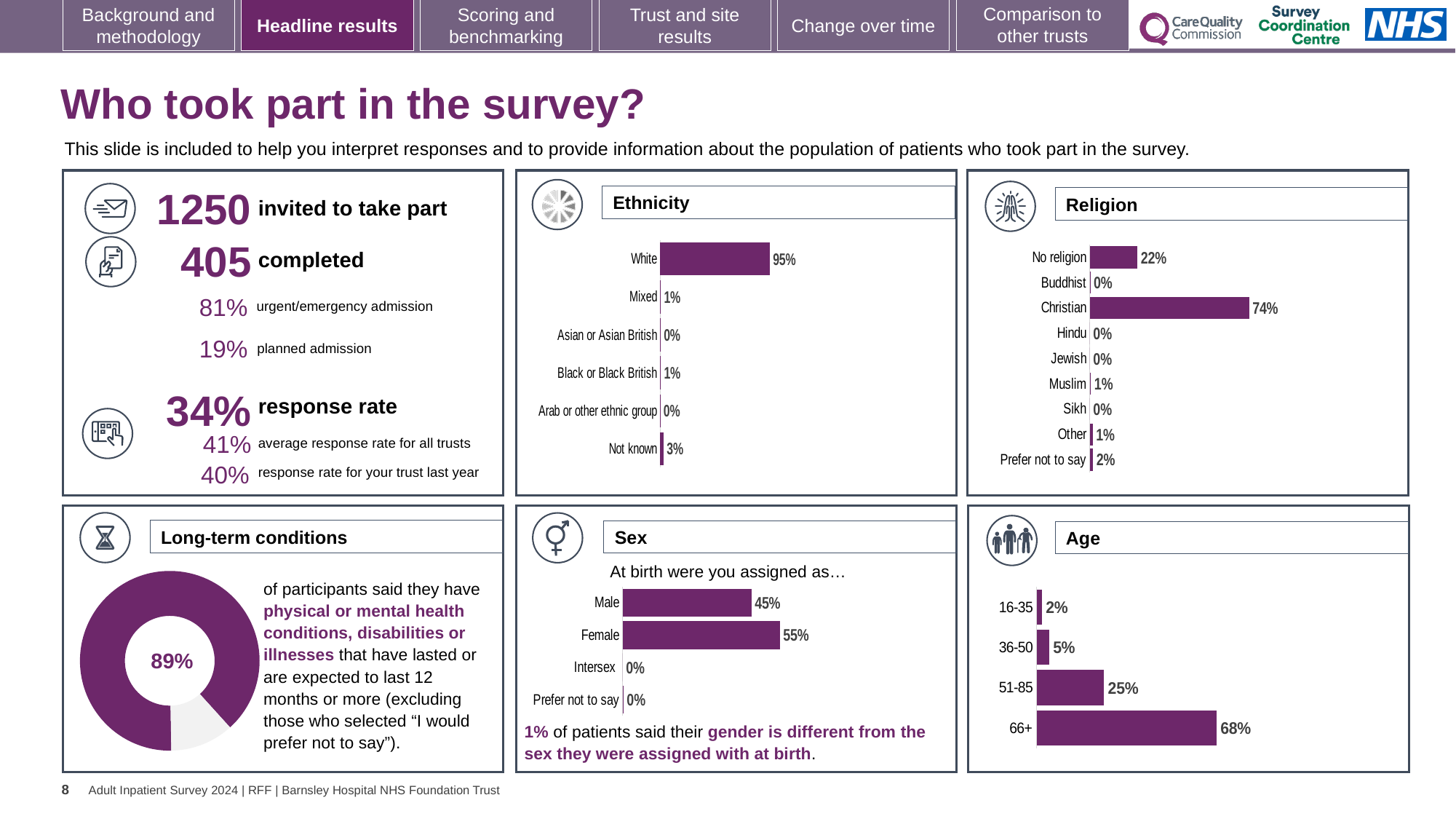
In the Age chart, which age group has the lowest value? 16-35 In the Sex chart, which is larger, Male or Female? Female In the Religion chart, what is the difference between the Christian and No religion values? 52% In the Ethnicity chart, what percentage of respondents are White? 95% In the Religion chart, how many categories are shown? 9 In the Ethnicity chart, which category has the highest value? White In the Age chart, do the values rise or fall as the age groups get older? rise In the Ethnicity chart, how many categories are shown? 6 What kind of chart is used in the Long-term conditions panel? doughnut chart In the Religion chart, what percentage of respondents are Christian? 74% In the Sex chart, what percentage of respondents were assigned Female at birth? 55% In the Age chart, what percentage of respondents are aged 66+? 68%